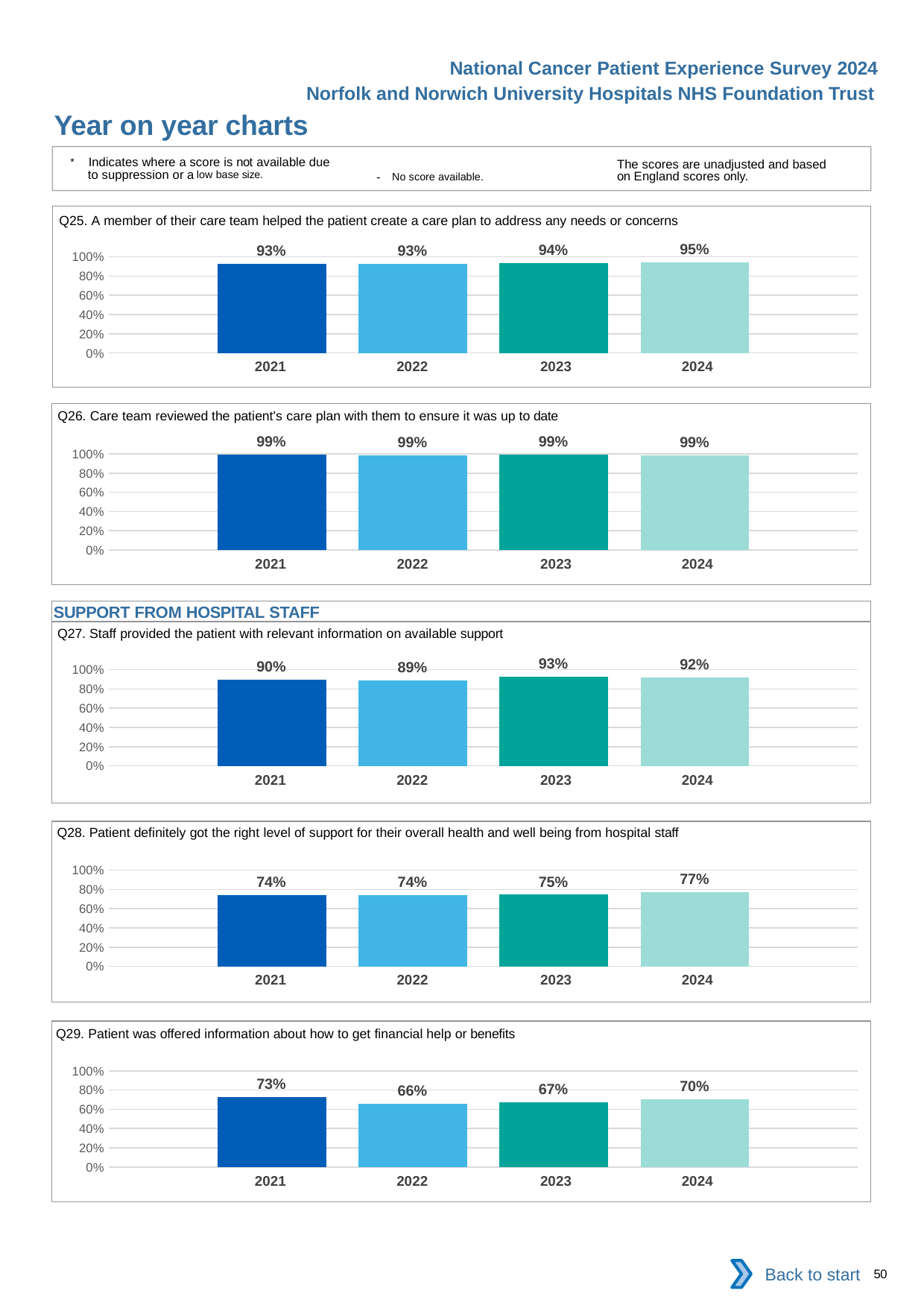
In the Q29 chart, which is larger, the value for 2022 or the value for 2024? 2024 In the Q28 chart, what is the value for 2024? 77% In the Q28 chart, is the value for 2021 greater or less than 80%? less In the Q25 chart, what is the value for 2024? 95% In the Q27 chart, which year has the lowest value? 2022 In the Q26 chart, what is the value for 2022? 99% In the Q29 chart, what is the difference between the 2021 and 2022 values? 7% What type of chart is the Q26 chart? bar chart In the Q27 chart, what is the difference between the 2023 and 2022 values? 4% In the Q29 chart, which year has the highest value? 2021 How many years are shown in the Q25 chart? 4 In the Q25 chart, which year has the highest value? 2024